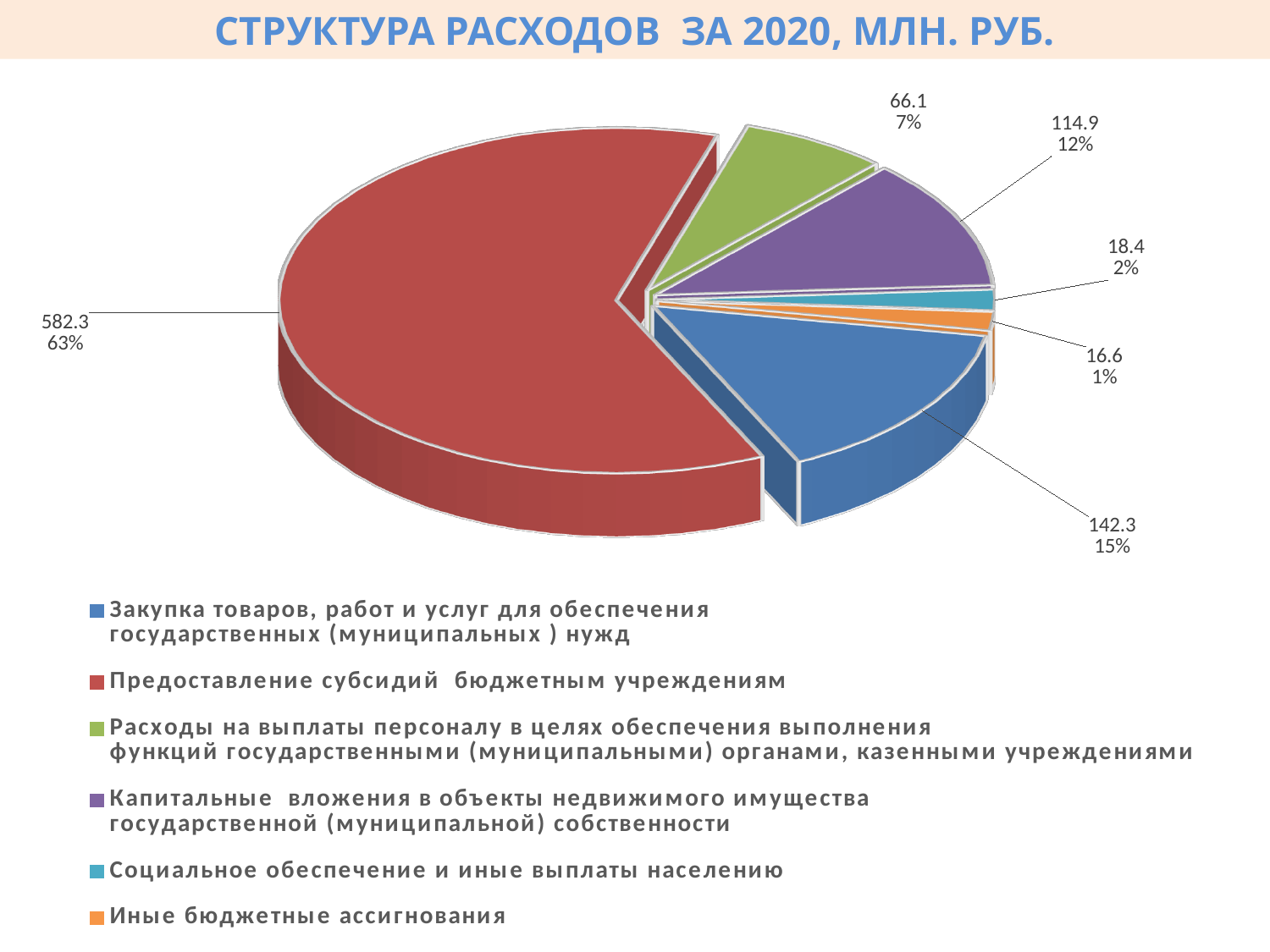
What is the title of the chart? СТРУКТУРА РАСХОДОВ ЗА 2020, МЛН. РУБ. Which category has the smallest slice? Иные бюджетные ассигнования Which category has the largest slice? Предоставление субсидий бюджетным учреждениям What is the value for Социальное обеспечение и иные выплаты населению? 18.4 What is the difference between the values for Предоставление субсидий бюджетным учреждениям and Закупка товаров, работ и услуг для обеспечения государственных (муниципальных) нужд? 440.0 Which is larger: the value for Капитальные вложения в объекты недвижимого имущества государственной (муниципальной) собственности or the value for Расходы на выплаты персоналу? Капитальные вложения в объекты недвижимого имущества государственной (муниципальной) собственности How many categories does the pie chart have? 6 What is the value for Закупка товаров, работ и услуг для обеспечения государственных (муниципальных) нужд? 142.3 What is the value for Предоставление субсидий бюджетным учреждениям? 582.3 What share of the pie does Капитальные вложения в объекты недвижимого имущества государственной (муниципальной) собственности represent? 12% What share of the pie does Расходы на выплаты персоналу в целях обеспечения выполнения функций государственными (муниципальными) органами, казенными учреждениями represent? 7% What type of chart is shown on the slide? pie chart